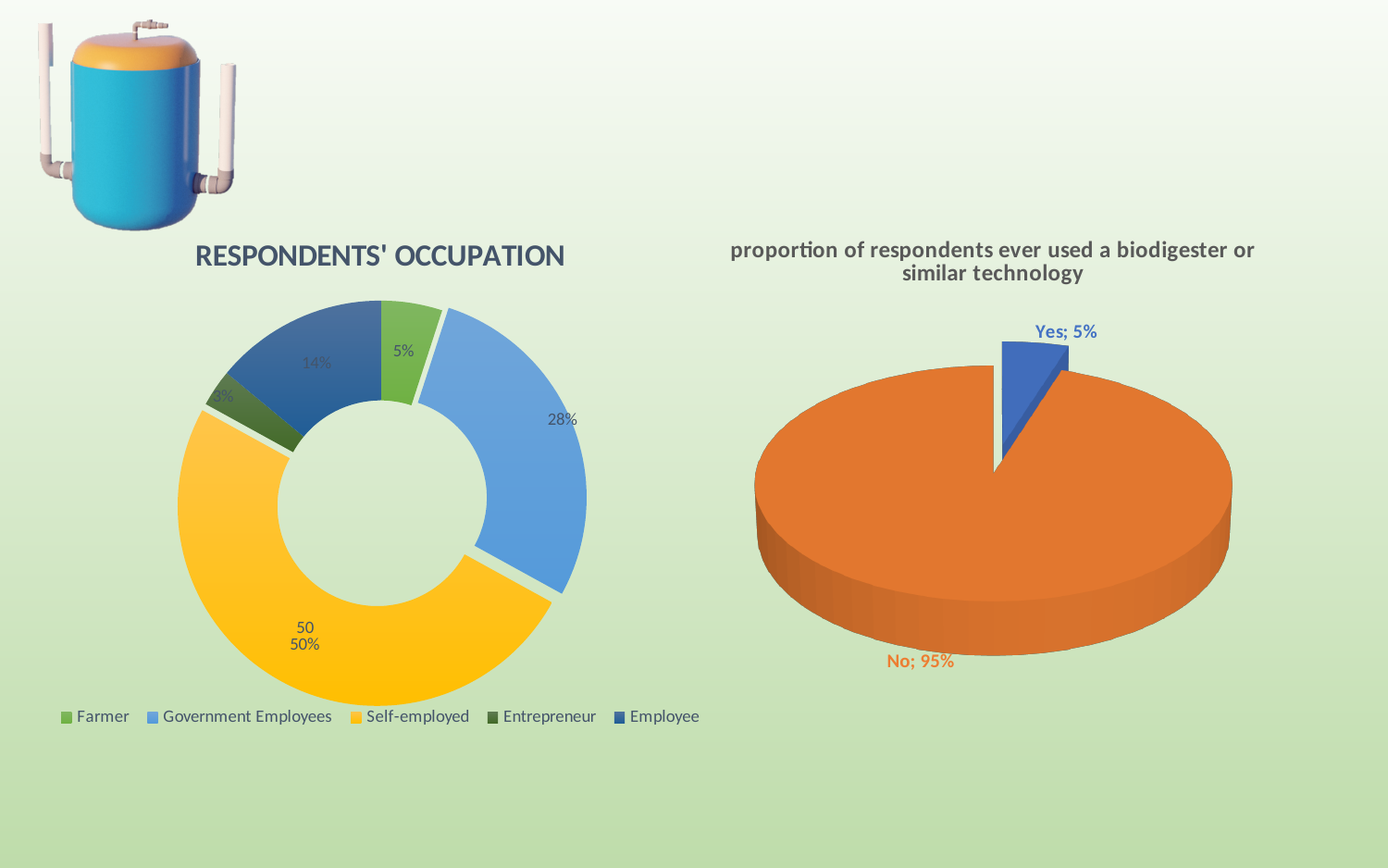
How many slices does the pie chart on the right about biodigester use have? 2 In the chart on the right about respondents who ever used a biodigester or similar technology, what percentage answered Yes? 5% In the RESPONDENTS' OCCUPATION chart, which is larger: the share of Government Employees or the share of Employees? Government Employees How many occupation categories does the legend of the RESPONDENTS' OCCUPATION chart list? 5 In the RESPONDENTS' OCCUPATION chart, what percentage of respondents are Government Employees? 28% What kind of chart is the RESPONDENTS' OCCUPATION chart? Doughnut chart In the chart on the right about respondents who ever used a biodigester or similar technology, what percentage answered No? 95% In the RESPONDENTS' OCCUPATION chart, how many percentage points larger is the Self-employed share than the Government Employees share? 22 percentage points In the RESPONDENTS' OCCUPATION chart, what percentage of respondents are Self-employed? 50% In the RESPONDENTS' OCCUPATION chart, what percentage of respondents are Employees? 14% In the RESPONDENTS' OCCUPATION chart, what percentage of respondents are Farmers? 5% In the RESPONDENTS' OCCUPATION chart, which occupation has the largest share? Self-employed